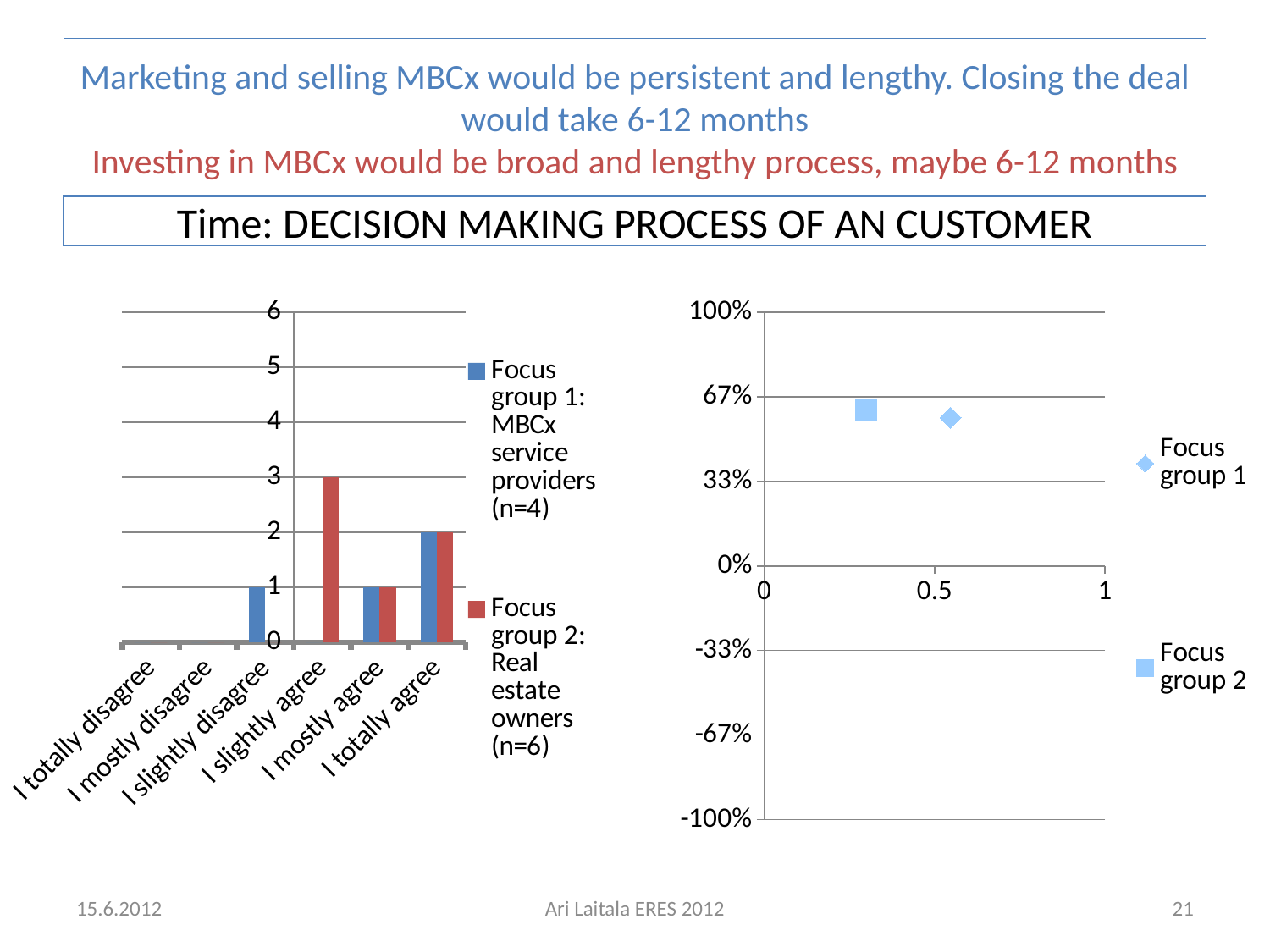
What kind of chart is the chart on the left of the slide? Bar chart On the right scatter chart, is the horizontal value of the Focus group 2 point greater or less than 0.5? less How many series does the legend of the left chart list? 2 On the left bar chart, what is the difference between the Focus group 2 value for 'I slightly agree' and its value for 'I mostly agree'? 2 What is the title shown above the two charts on the slide? Time: DECISION MAKING PROCESS OF AN CUSTOMER On the left bar chart, for 'I slightly agree', which series has the larger value: Focus group 1 or Focus group 2? Focus group 2 On the left bar chart, which category has the highest value for Focus group 2: Real estate owners (n=6)? I slightly agree How many categories are shown on the x axis of the left bar chart? 6 On the left bar chart, what is the value for Focus group 1: MBCx service providers (n=4) for 'I slightly disagree'? 1 On the left bar chart, what is the value for Focus group 2: Real estate owners (n=6) for 'I slightly agree'? 3 On the right scatter chart, is the vertical value of the Focus group 1 point greater or less than 33%? greater On the left bar chart, what is the value for Focus group 1: MBCx service providers (n=4) for 'I totally agree'? 2